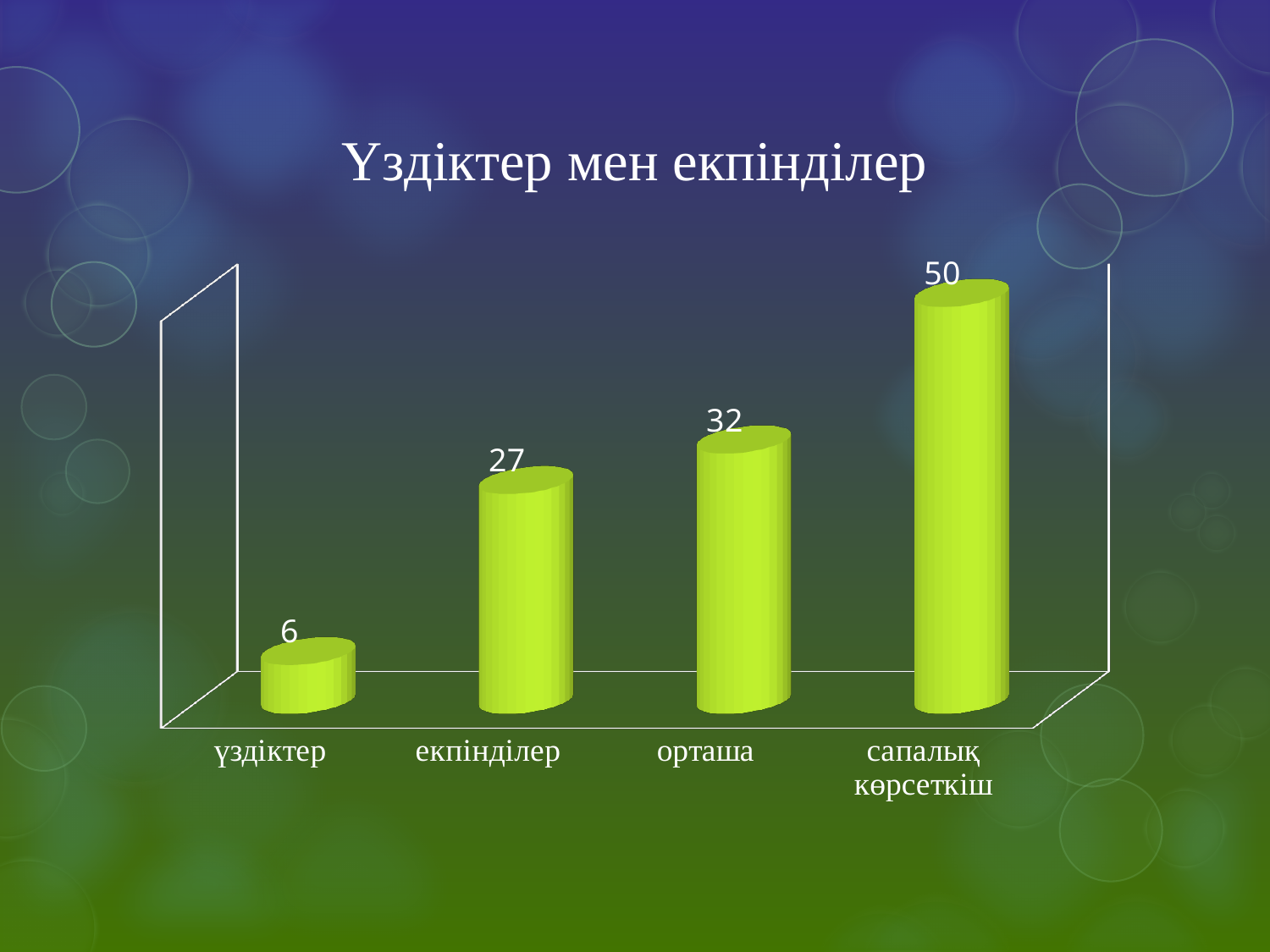
What is the difference between the values for сапалық көрсеткіш and орташа? 18 What is the title of the chart? Үздіктер мен екпінділер What is the value for орташа? 32 Which category has the lowest value? үздіктер Which category has the highest value? сапалық көрсеткіш How many categories are shown in the chart? 4 What kind of chart is shown on the slide? bar chart What is the value for сапалық көрсеткіш? 50 Which is larger, the value for орташа or the value for екпінділер? орташа What is the value for екпінділер? 27 What is the value for үздіктер? 6 What is the difference between the values for екпінділер and үздіктер? 21